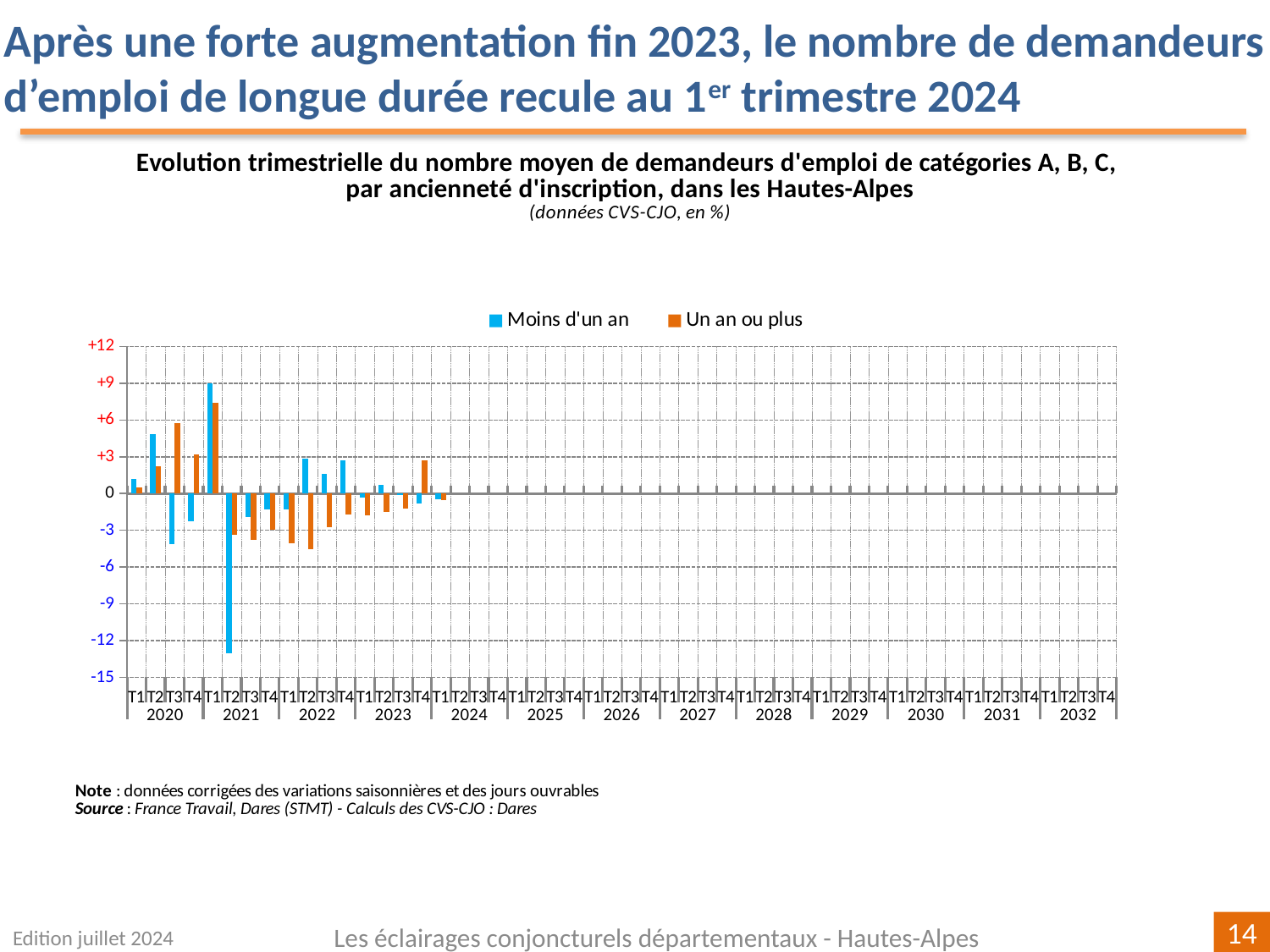
What kind of chart is shown on the slide? bar chart Is the value for 'Moins d'un an' in T1 2021 greater or less than +6? greater Is the value for 'Moins d'un an' in T2 2021 greater or less than -9? less In which quarter is the value for 'Moins d'un an' the lowest? T2 2021 In T3 2020, which series has the larger value, 'Moins d'un an' or 'Un an ou plus'? Un an ou plus How many series does the legend list? 2 Is the value for 'Un an ou plus' in T3 2020 greater or less than +3? greater In T1 2021, which series has the larger value, 'Moins d'un an' or 'Un an ou plus'? Moins d'un an What are the two series named in the legend? Moins d'un an; Un an ou plus In which quarter is the value for 'Un an ou plus' the highest? T1 2021 In which quarter is the value for 'Moins d'un an' the highest? T1 2021